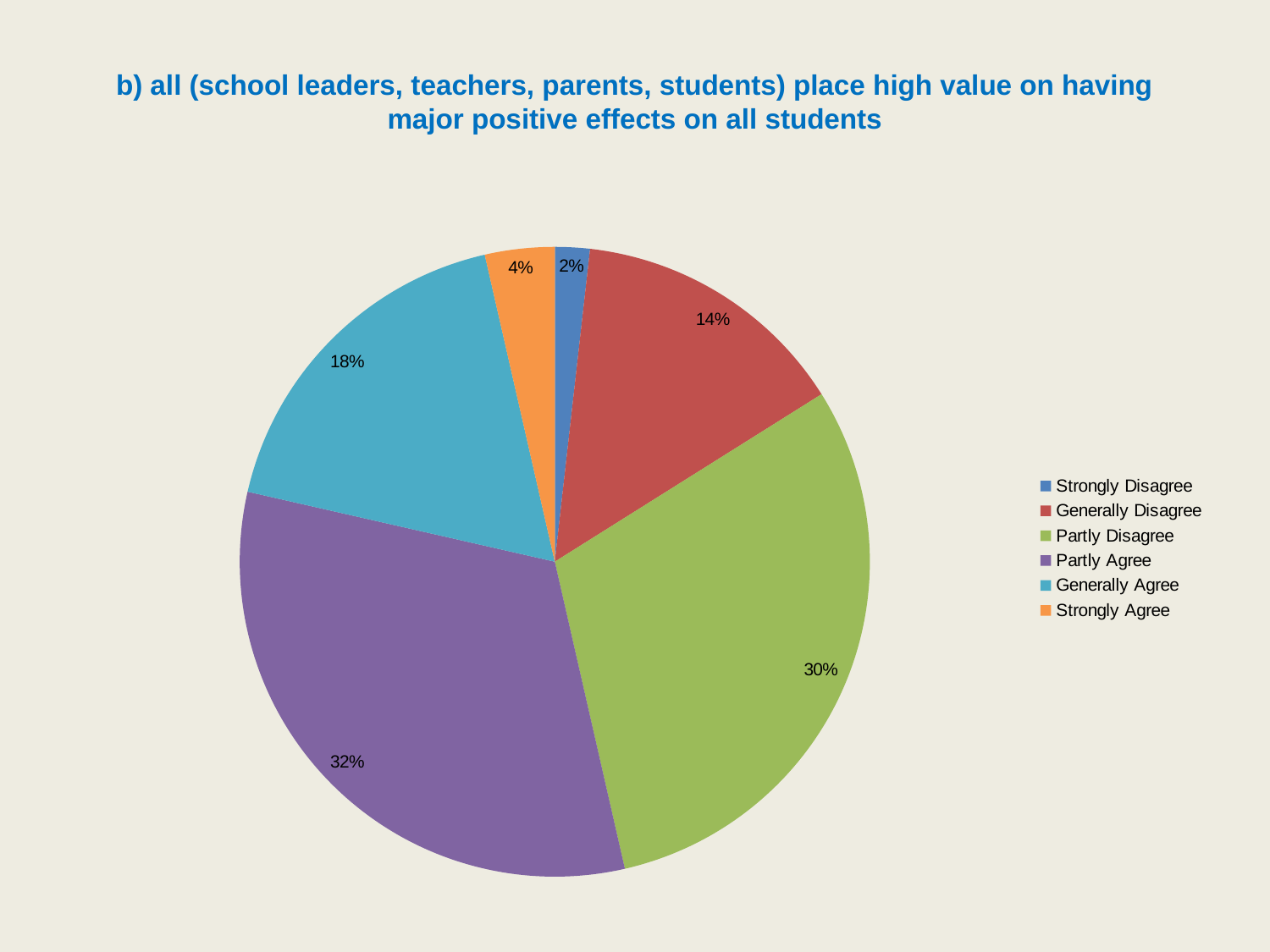
What colour is the Partly Disagree slice? green What percentage of respondents chose Generally Agree? 18% Which response category has the largest share of the pie? Partly Agree What is the combined share of Partly Agree, Generally Agree and Strongly Agree? 54% What kind of chart is shown on the slide? pie chart How many categories does the pie chart have? 6 What percentage of respondents chose Strongly Agree? 4% What percentage of respondents chose Partly Agree? 32% What percentage of respondents chose Generally Disagree? 14% Which is larger, the share for Generally Agree or the share for Generally Disagree? Generally Agree What is the difference in percentage points between Partly Disagree and Generally Disagree? 16 Which response category has the smallest share of the pie? Strongly Disagree